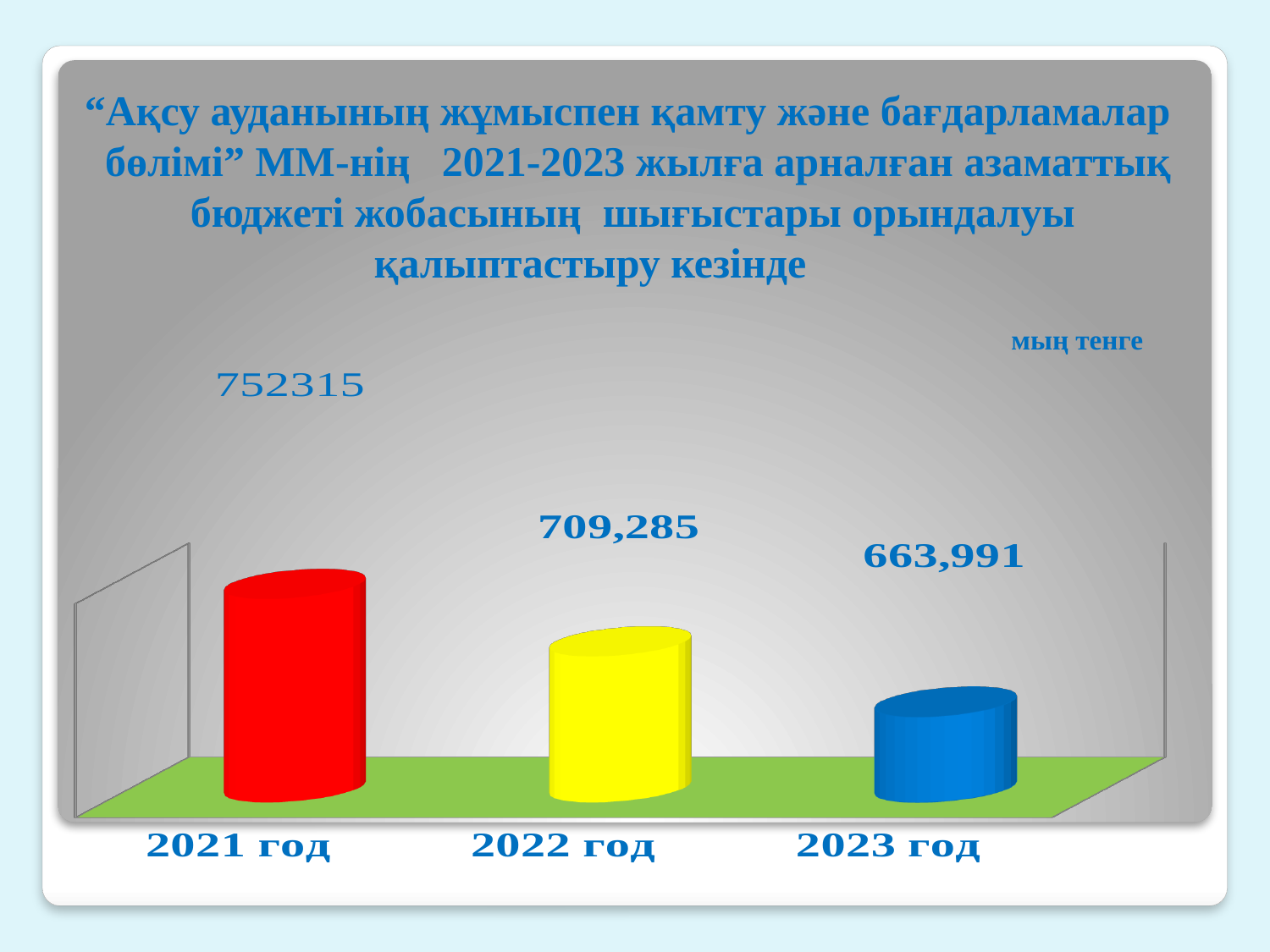
Which year has the lowest value? 2023 год What is the value for 2021 год? 752315 What is the value for 2023 год? 663,991 How many years are shown on the chart? 3 What colour is the bar for 2022 год? yellow Do the values rise or fall from 2021 год to 2023 год? fall What is the difference between the values for 2022 год and 2023 год? 45,294 What kind of chart is shown on the slide? bar chart Which is larger, the value for 2021 год or the value for 2022 год? 2021 год What unit is indicated above the chart? мың тенге Which year has the highest value? 2021 год What is the value for 2022 год? 709,285